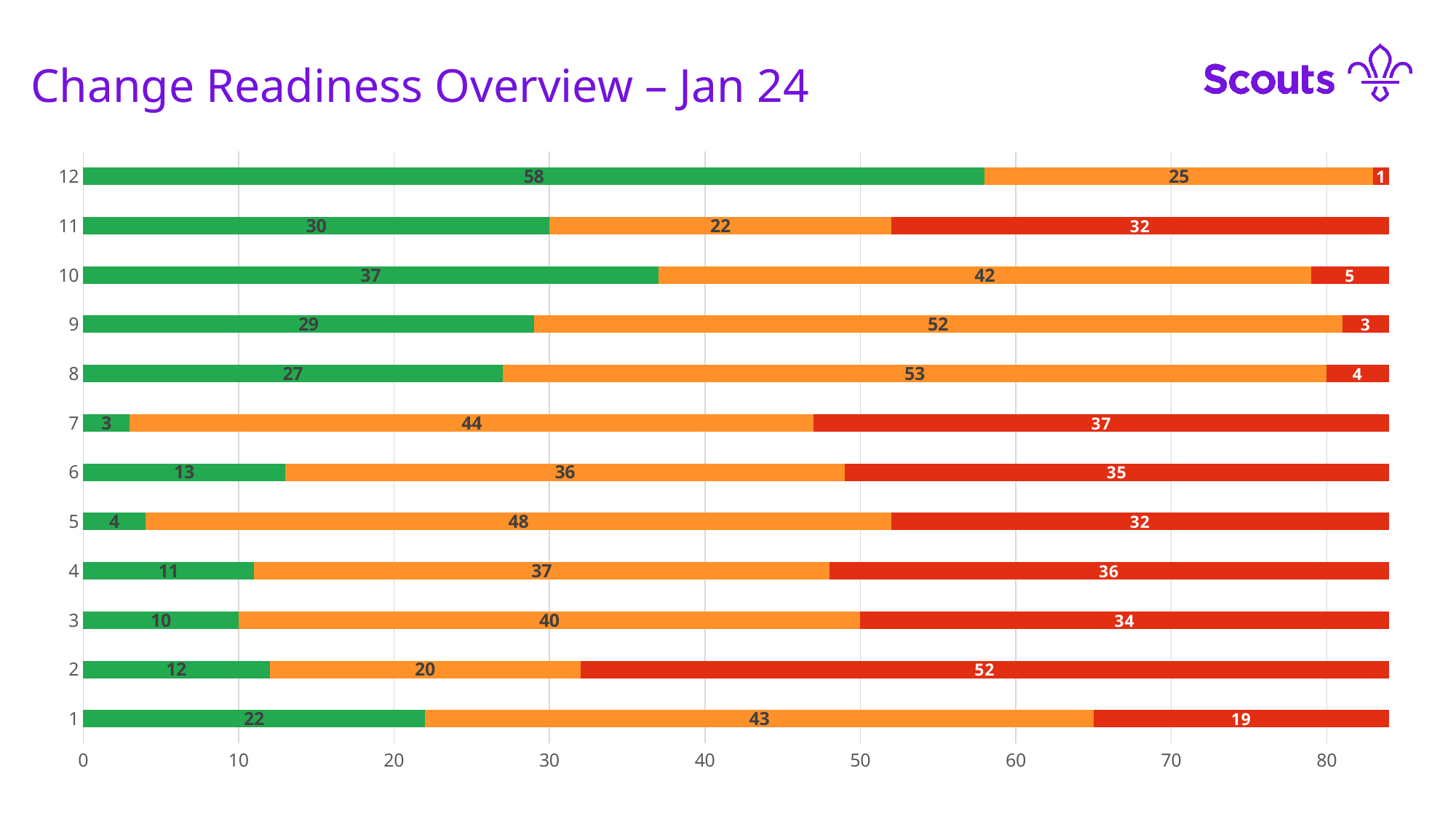
What is the title of the chart? Change Readiness Overview – Jan 24 What is the value of the red segment for category 2? 52 What type of chart is shown on the slide? Stacked bar chart What is the difference between the red segment of category 11 and the red segment of category 10? 27 What is the total of the stacked bar for category 1? 84 What is the value of the green segment for category 12? 58 Which category has the smallest green segment? 7 Is the green segment for category 10 greater or less than 30? greater Which is larger: the orange segment for category 9 or the orange segment for category 6? Category 9 Which category has the largest green segment? 12 How many categories are shown on the vertical axis? 12 What is the value of the orange segment for category 8? 53